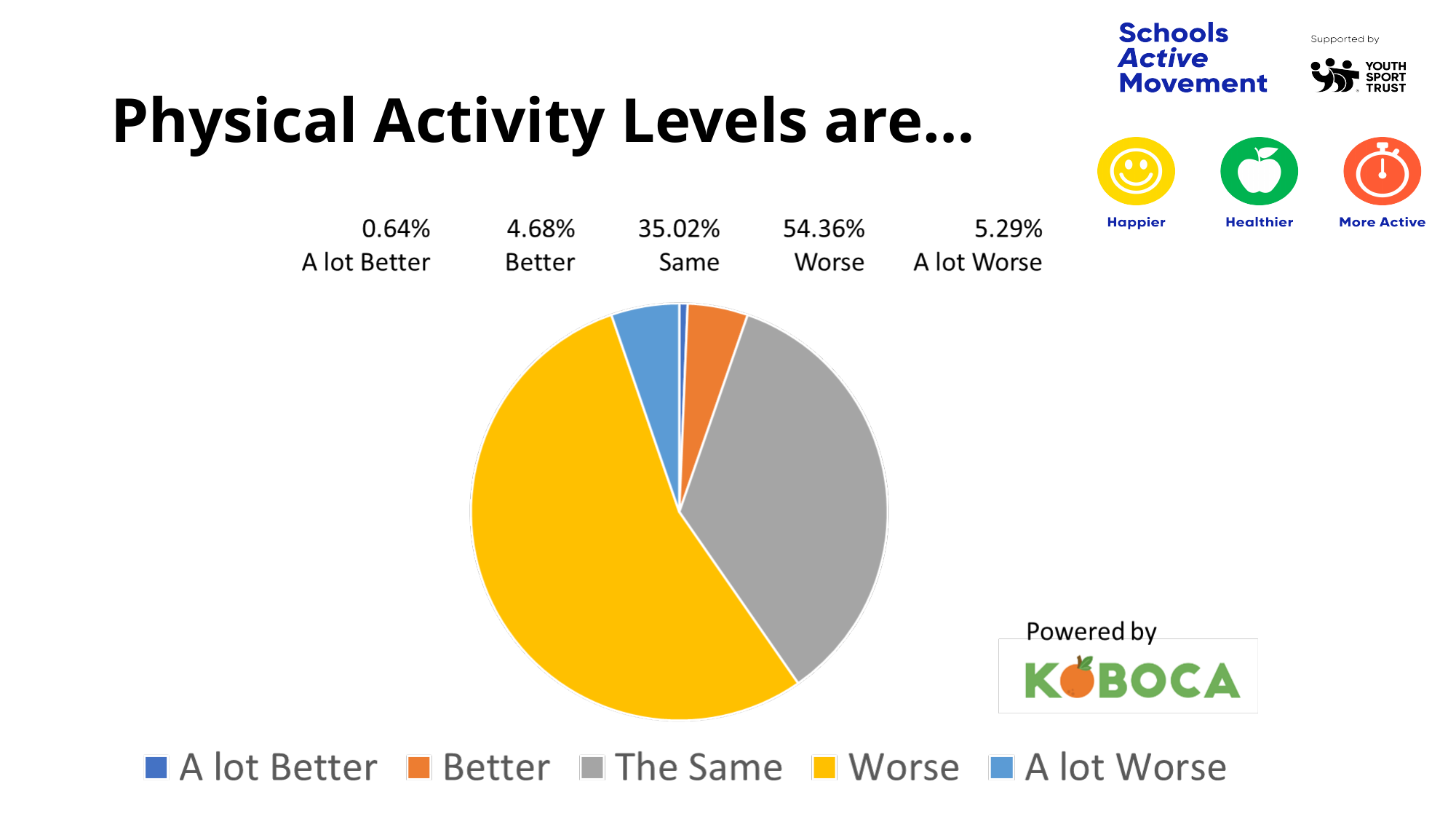
How many categories does the pie chart show? 5 Which category has the smallest share of the pie? A lot Better What is the difference in percentage points between 'Worse' and 'Same'? 19.34 What percentage of responses are 'Worse'? 54.36% What is the combined percentage of 'Worse' and 'A lot Worse'? 59.65% What colour is the 'Worse' slice in the pie chart? Yellow What percentage of responses are 'A lot Worse'? 5.29% Which category has the largest share of the pie? Worse What type of chart is shown on the slide? Pie chart Which is larger, the share for 'Better' or the share for 'A lot Worse'? A lot Worse What percentage of responses are 'A lot Better'? 0.64% What percentage of responses are 'Same'? 35.02%